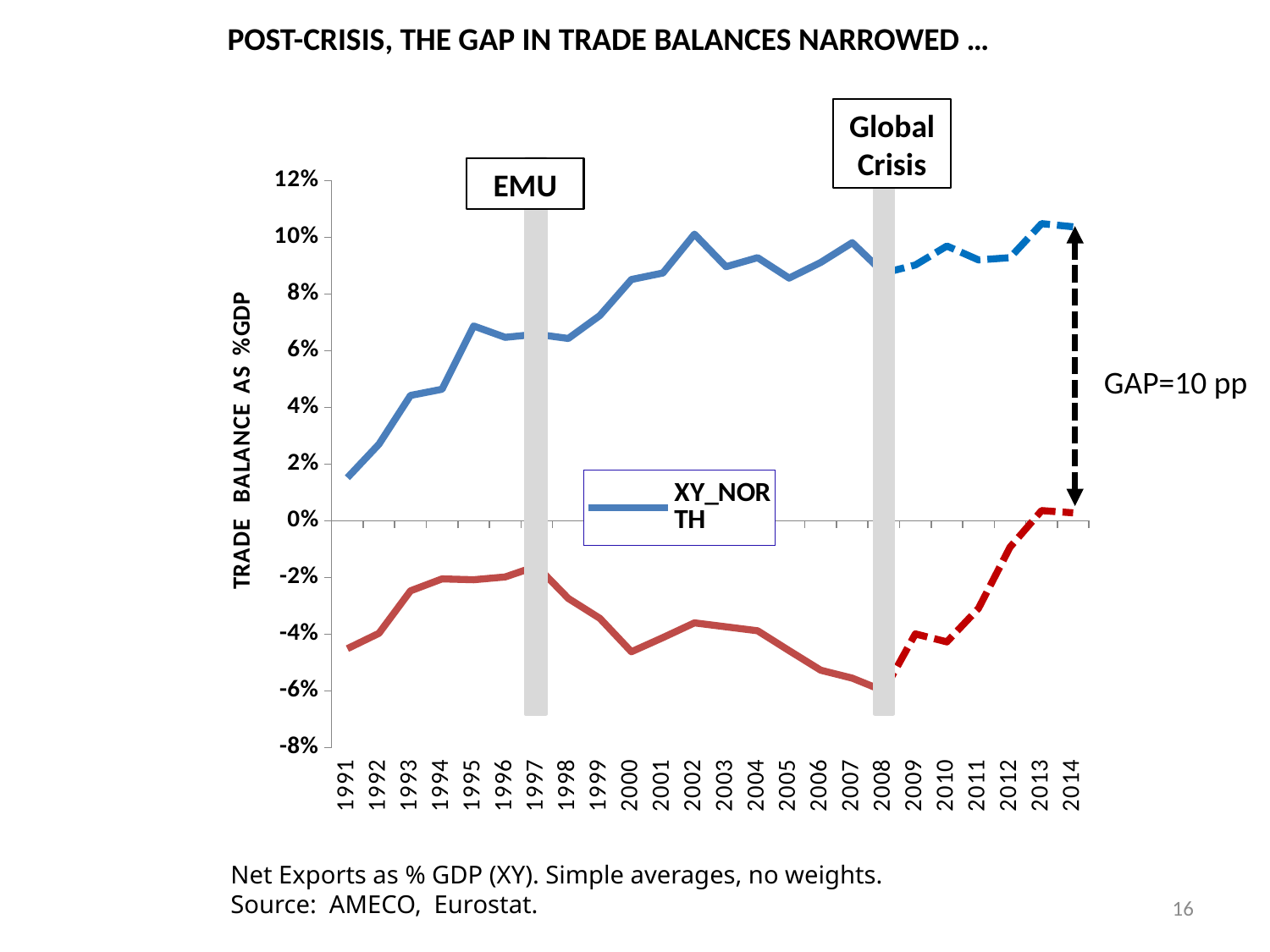
In which year is the red line at its lowest? 2008 How many years are shown on the x axis of the chart? 24 How many series does the chart's legend list? 1 Is the value of the red line in 2008 greater or less than -4%? less In which year is the XY_NORTH line at its lowest? 1991 Is the value for XY_NORTH in 2000 greater or less than 8%? greater Which is larger for XY_NORTH, the value in 1991 or the value in 2014? 2014 Does the red line rise or fall from 2008 to 2013? Rise Is the value for XY_NORTH in 1991 greater or less than 2%? less What gap between the two lines is annotated at the right of the chart? GAP=10 pp What kind of chart is shown on the slide? Line chart Which series is named in the chart's legend? XY_NORTH